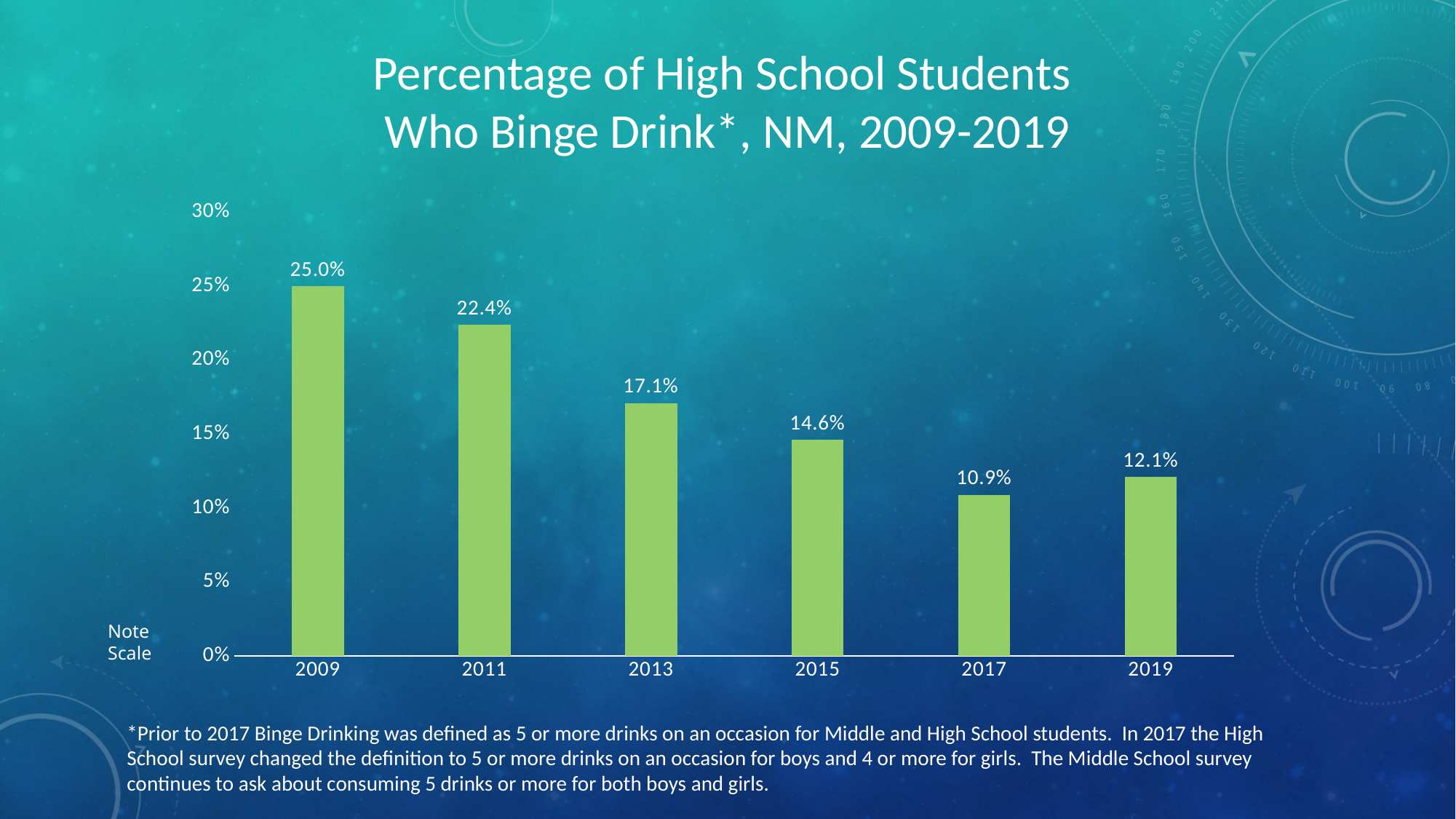
Which is larger, the value for 2017 or the value for 2019? 2019 Which year has the lowest percentage of binge drinking? 2017 What is the value shown for 2019? 12.1% What is the value shown for 2015? 14.6% Is the value for 2013 greater or less than 15%? greater Which year has the highest percentage of binge drinking? 2009 What is the difference between the 2009 value and the 2011 value? 2.6% How many years are shown on the x axis? 6 What percentage of high school students binge drank in 2009? 25.0% What kind of chart is shown on the slide? bar chart What is the difference between the 2013 value and the 2019 value? 5.0% Do the values generally rise or fall from 2009 to 2017? fall